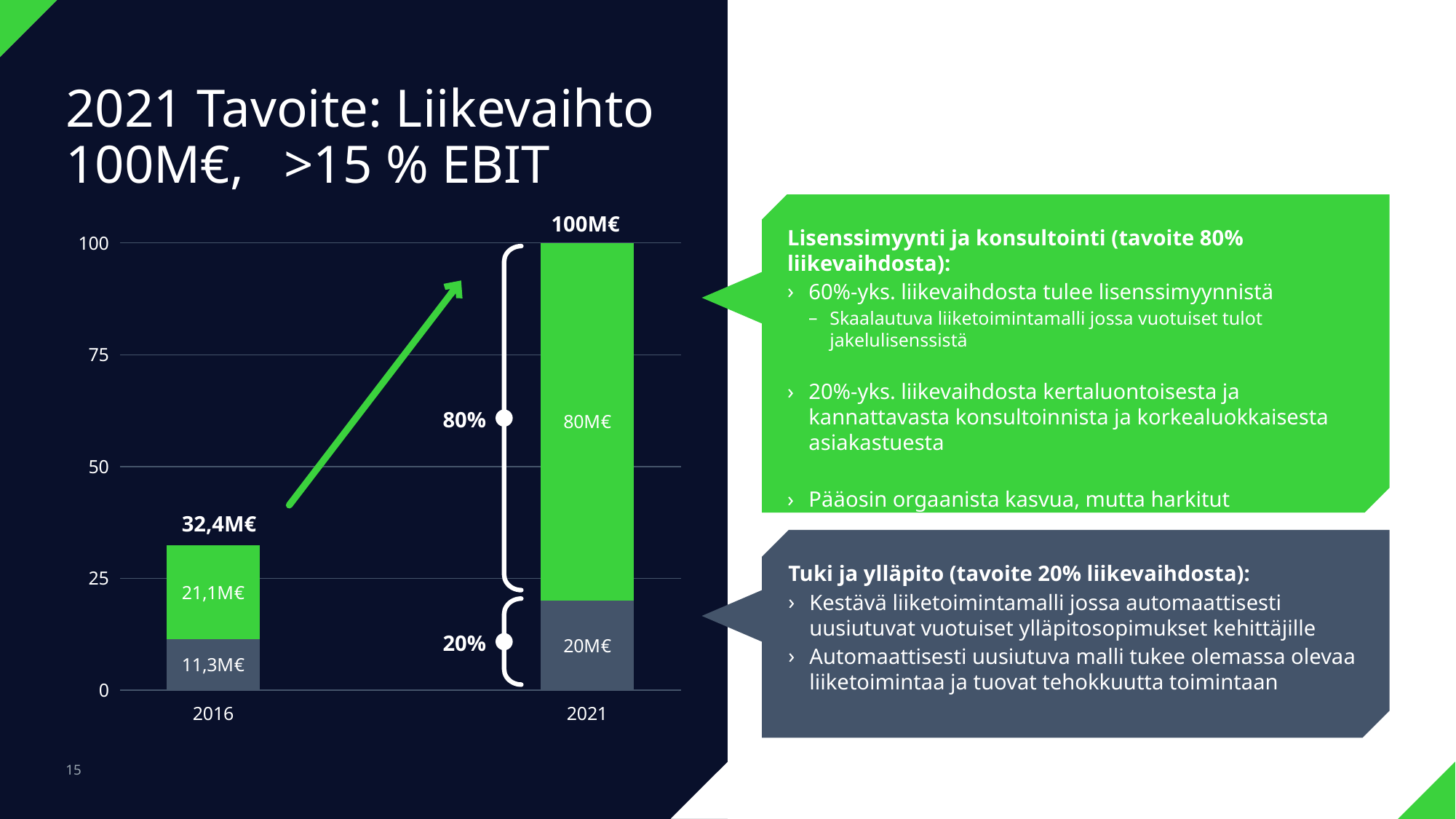
What is the total value shown above the 2021 bar? 100M€ What percentage label is shown next to the green segment of the 2021 bar? 80% What is the value of the grey segment of the 2021 bar? 20M€ What kind of chart is shown on the slide? Stacked bar chart Which year has the higher total bar value, 2016 or 2021? 2021 How many years (categories) are shown on the x axis? 2 What is the value of the green segment of the 2016 bar? 21,1M€ What is the difference between the grey segment values of 2021 and 2016? 8,7M€ What is the value of the green segment of the 2021 bar? 80M€ What is the difference between the green segment values of 2021 and 2016? 58,9M€ What is the value of the grey segment of the 2016 bar? 11,3M€ What is the total value shown above the 2016 bar? 32,4M€